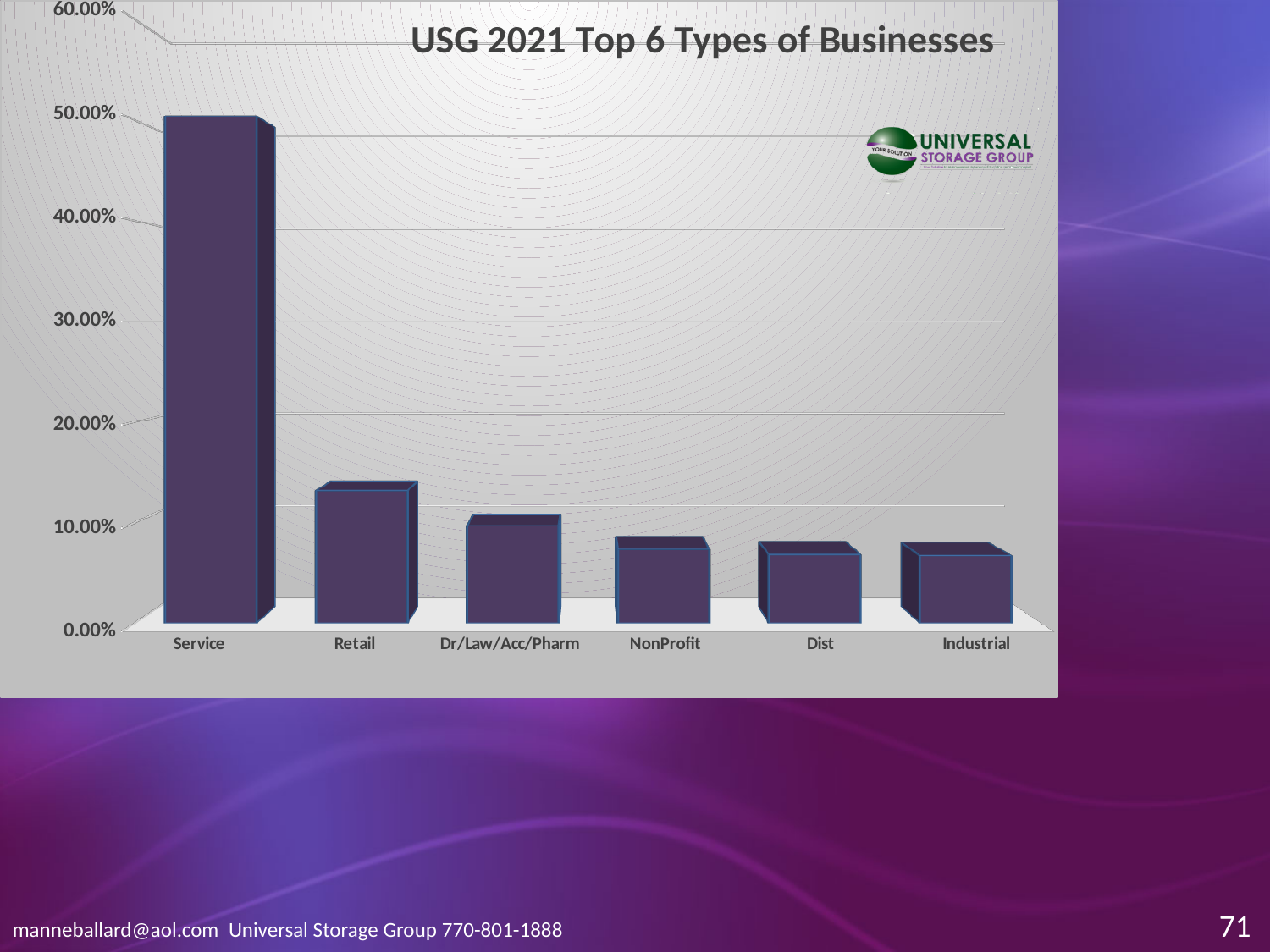
Which is larger, the value for Retail or the value for NonProfit? Retail Which is larger, the value for Service or the value for Retail? Service What is the highest value shown on the y axis of the chart? 60.00% What is the title of the chart? USG 2021 Top 6 Types of Businesses How many business types are shown on the x axis of the chart? 6 Is the value for Retail greater or less than 10.00%? greater Is the value for Service greater or less than 40.00%? greater Is the value for Industrial greater or less than 10.00%? less Do the values rise or fall moving from left to right along the x axis? fall Which business type has the highest value in the chart? Service What type of chart is shown on the slide? bar chart